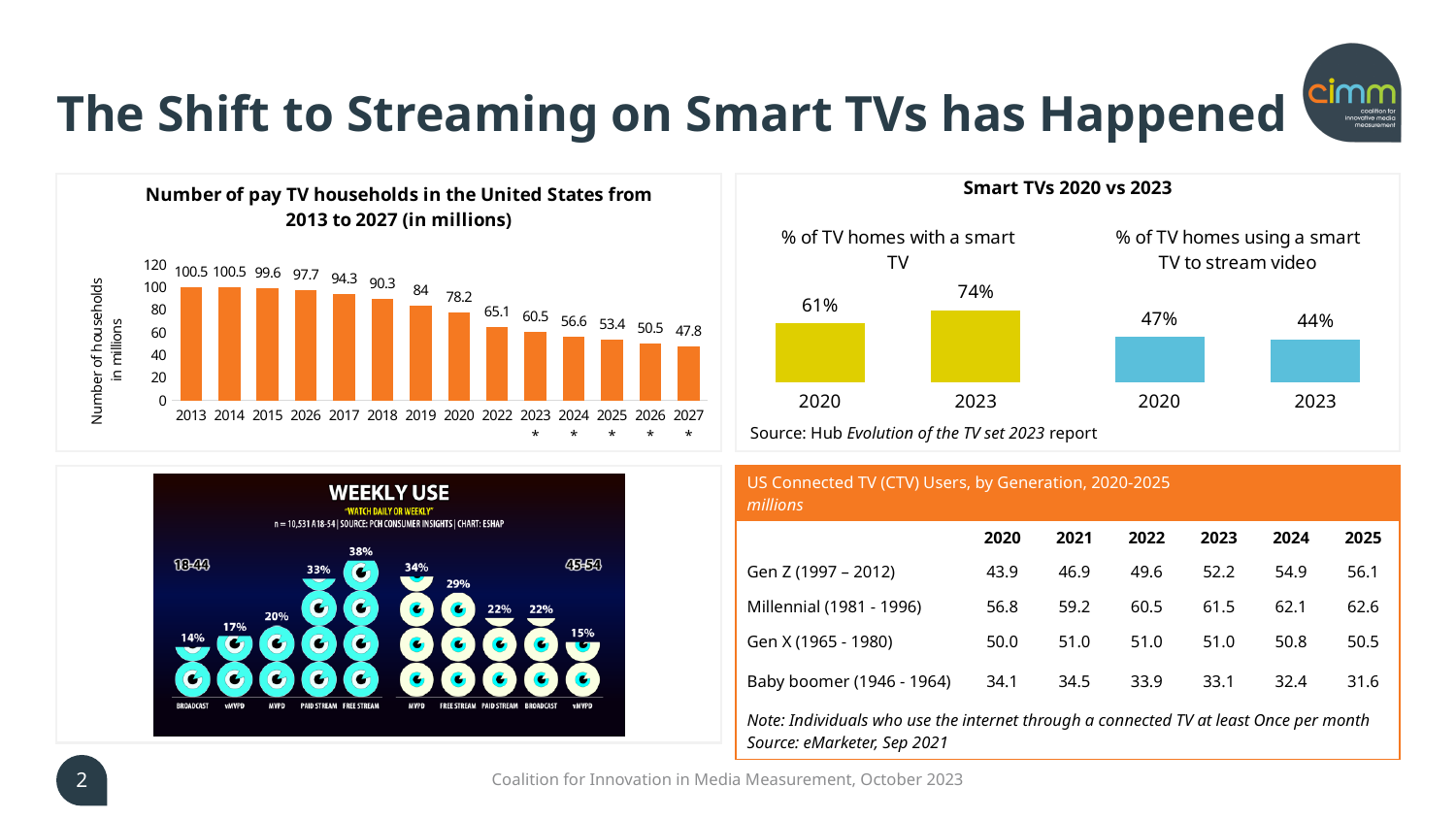
How many bars are plotted in the chart 'Number of pay TV households in the United States from 2013 to 2027 (in millions)'? 14 In the chart 'Number of pay TV households in the United States from 2013 to 2027 (in millions)', which year has the lowest value? 2027 What kind of chart is 'Number of pay TV households in the United States from 2013 to 2027 (in millions)'? bar chart In the 'Smart TVs 2020 vs 2023' panel, is the % of TV homes with a smart TV larger in 2020 or in 2023? 2023 In the chart 'Number of pay TV households in the United States from 2013 to 2027 (in millions)', do the values rise or fall from left to right along the x axis? fall In the 'Smart TVs 2020 vs 2023' panel, what is the % of TV homes with a smart TV in 2023? 74% In the 'Smart TVs 2020 vs 2023' panel, what is the difference between the 2020 and 2023 values for % of TV homes using a smart TV to stream video? 3% In the chart 'Number of pay TV households in the United States from 2013 to 2027 (in millions)', what is the value for 2027? 47.8 In the 'Weekly Use' chart, what is the percentage shown for Broadcast in the 18-44 group? 14% In the 'Weekly Use' chart, what is the highest percentage shown for the 18-44 group? 38% In the chart 'Number of pay TV households in the United States from 2013 to 2027 (in millions)', what is the value for 2019? 84 In the chart 'Number of pay TV households in the United States from 2013 to 2027 (in millions)', what is the difference between the 2020 value and the 2022 value? 13.1